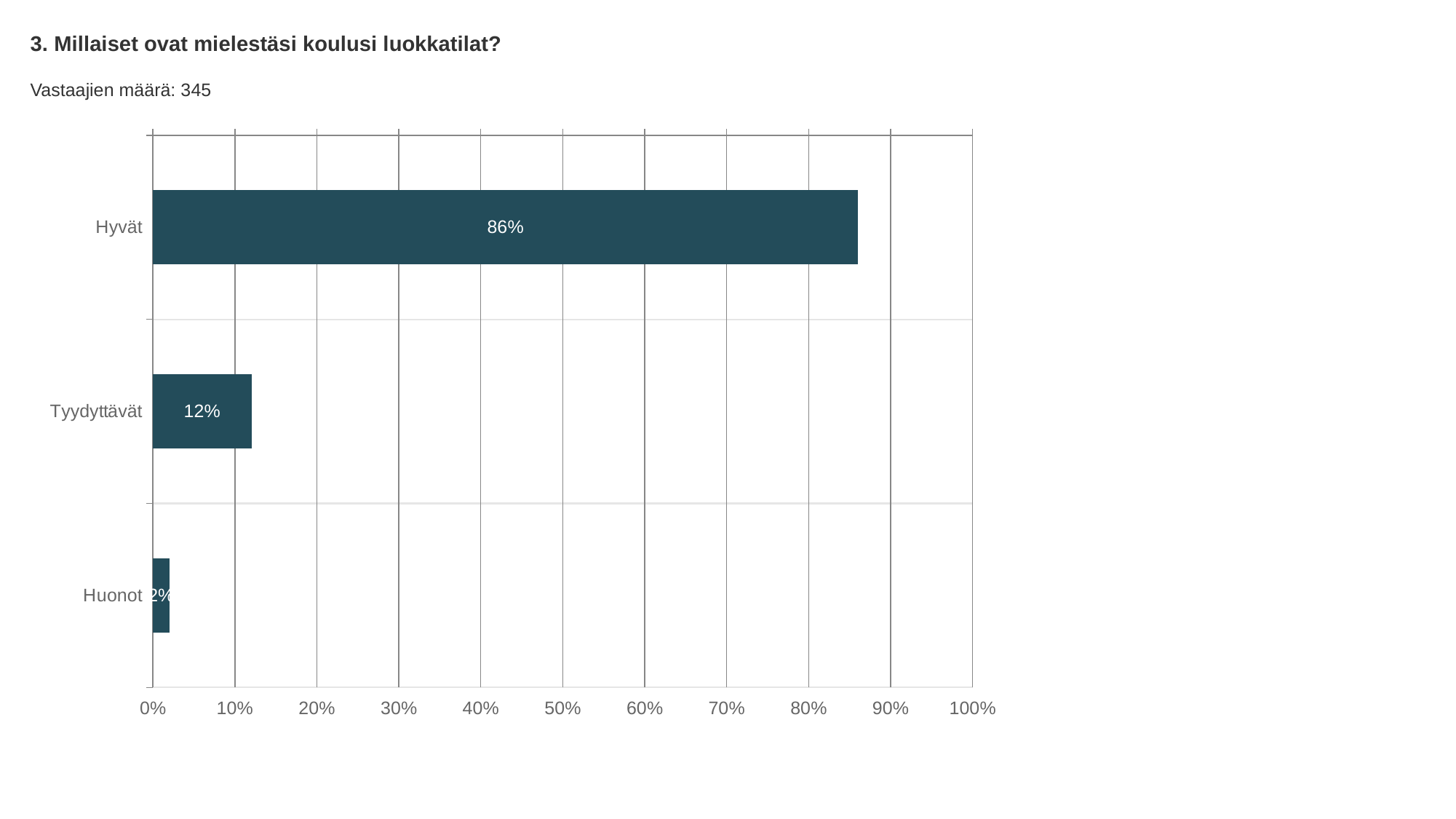
What kind of chart is shown on the slide? bar chart What is the value for Hyvät? 86% How many respondents (Vastaajien määrä) are reported on the slide? 345 What is the value for Tyydyttävät? 12% Which is larger, the value for Tyydyttävät or the value for Huonot? Tyydyttävät How many categories are shown in the chart? 3 What is the value for Huonot? 2% Is the value for Hyvät greater or less than 80%? greater Which category has the highest value? Hyvät What is the difference between the values for Hyvät and Tyydyttävät? 74% What is the difference between the values for Tyydyttävät and Huonot? 10% Which category has the lowest value? Huonot